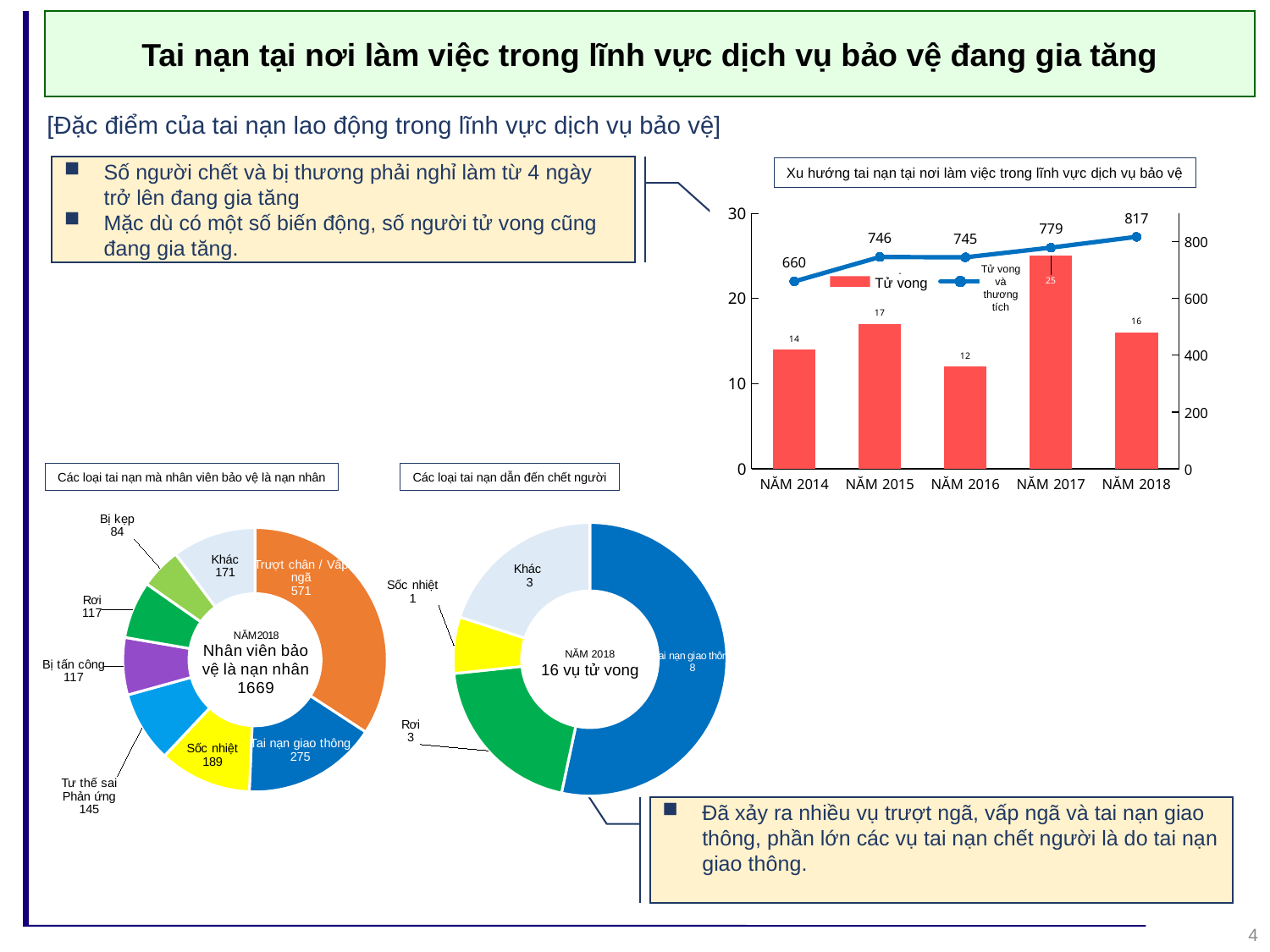
In the chart 'Xu hướng tai nạn tại nơi làm việc trong lĩnh vực dịch vụ bảo vệ', does the 'Tử vong và thương tích' line generally rise or fall from NĂM 2014 to NĂM 2018? rise In the chart 'Xu hướng tai nạn tại nơi làm việc trong lĩnh vực dịch vụ bảo vệ', which year has the lowest 'Tử vong' value? NĂM 2016 In the chart 'Xu hướng tai nạn tại nơi làm việc trong lĩnh vực dịch vụ bảo vệ', what is the difference between the 'Tử vong và thương tích' values for NĂM 2018 and NĂM 2014? 157 In the chart 'Xu hướng tai nạn tại nơi làm việc trong lĩnh vực dịch vụ bảo vệ', which year has the highest 'Tử vong và thương tích' value? NĂM 2018 In the chart 'Xu hướng tai nạn tại nơi làm việc trong lĩnh vực dịch vụ bảo vệ', how many series does the legend list? 2 In the chart 'Các loại tai nạn mà nhân viên bảo vệ là nạn nhân', which category has the smallest value? Bị kẹp In the chart 'Các loại tai nạn mà nhân viên bảo vệ là nạn nhân', what is the value for 'Trượt chân / Vấp ngã'? 571 In the chart 'Các loại tai nạn mà nhân viên bảo vệ là nạn nhân', which is larger: 'Sốc nhiệt' or 'Tư thế sai Phản ứng'? Sốc nhiệt What kind of chart is 'Các loại tai nạn dẫn đến chết người'? Donut chart In the chart 'Xu hướng tai nạn tại nơi làm việc trong lĩnh vực dịch vụ bảo vệ', what is the value of 'Tử vong và thương tích' for NĂM 2014? 660 In the chart 'Xu hướng tai nạn tại nơi làm việc trong lĩnh vực dịch vụ bảo vệ', what is the value of 'Tử vong' for NĂM 2017? 25 In the chart 'Các loại tai nạn dẫn đến chết người', what is the value for 'Tai nạn giao thông'? 8